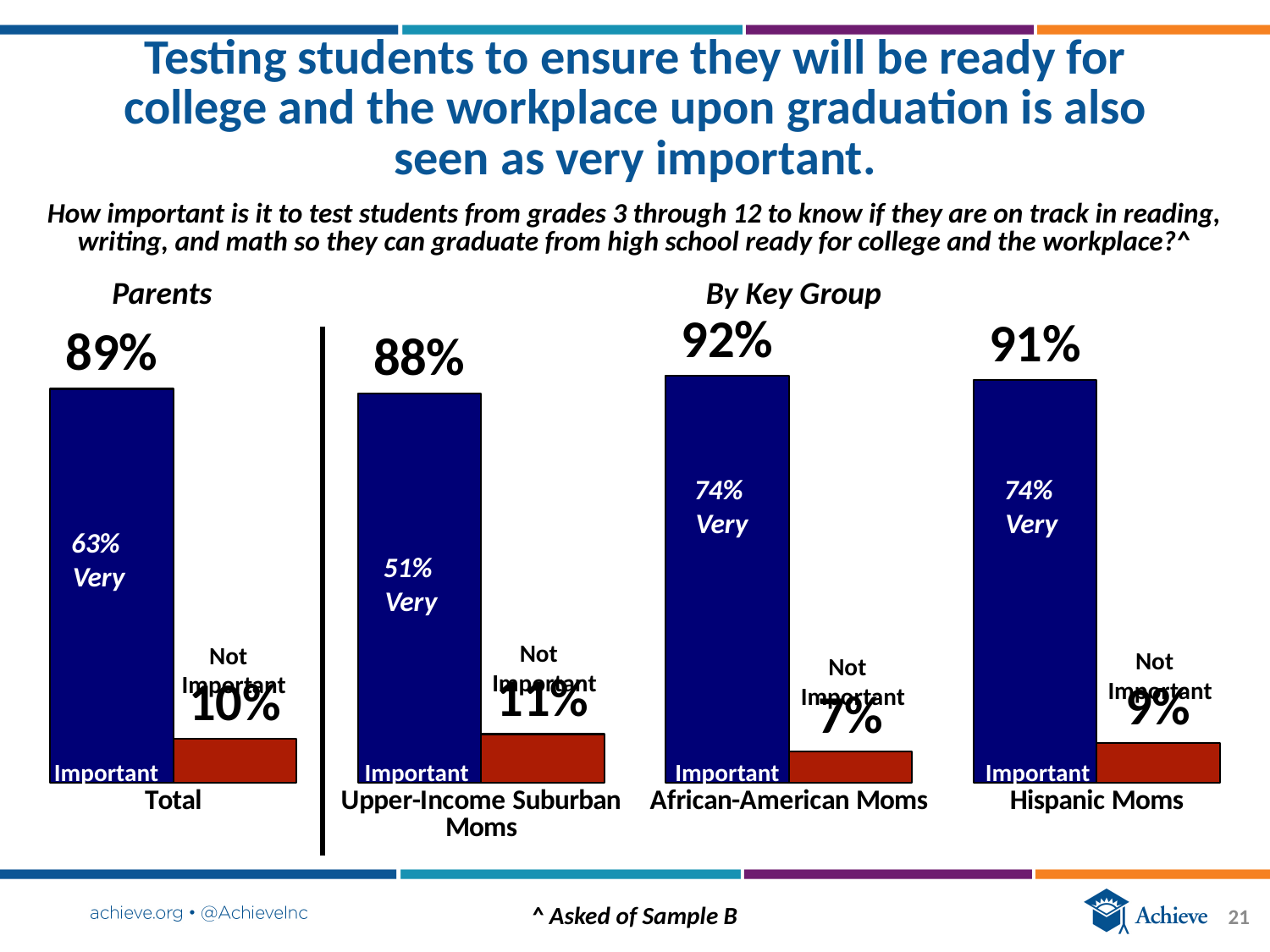
What percentage of African-American Moms says testing is Important? 92% What share of Hispanic Moms says testing is Very important? 74% Which group has the highest Important percentage? African-American Moms How many groups are shown in the chart? 4 What percentage of Upper-Income Suburban Moms says testing is Not Important? 11% Which is larger: the Very important share for the Total group or for Upper-Income Suburban Moms? Total What percentage of the Total group says testing is Important? 89% What is the difference between the Important and Not Important percentages for the Total group? 79 percentage points What is the Not Important percentage for Hispanic Moms? 9% What kind of chart is shown on the slide? Bar chart What colour are the Important bars? Blue Which group has the lowest Not Important percentage? African-American Moms